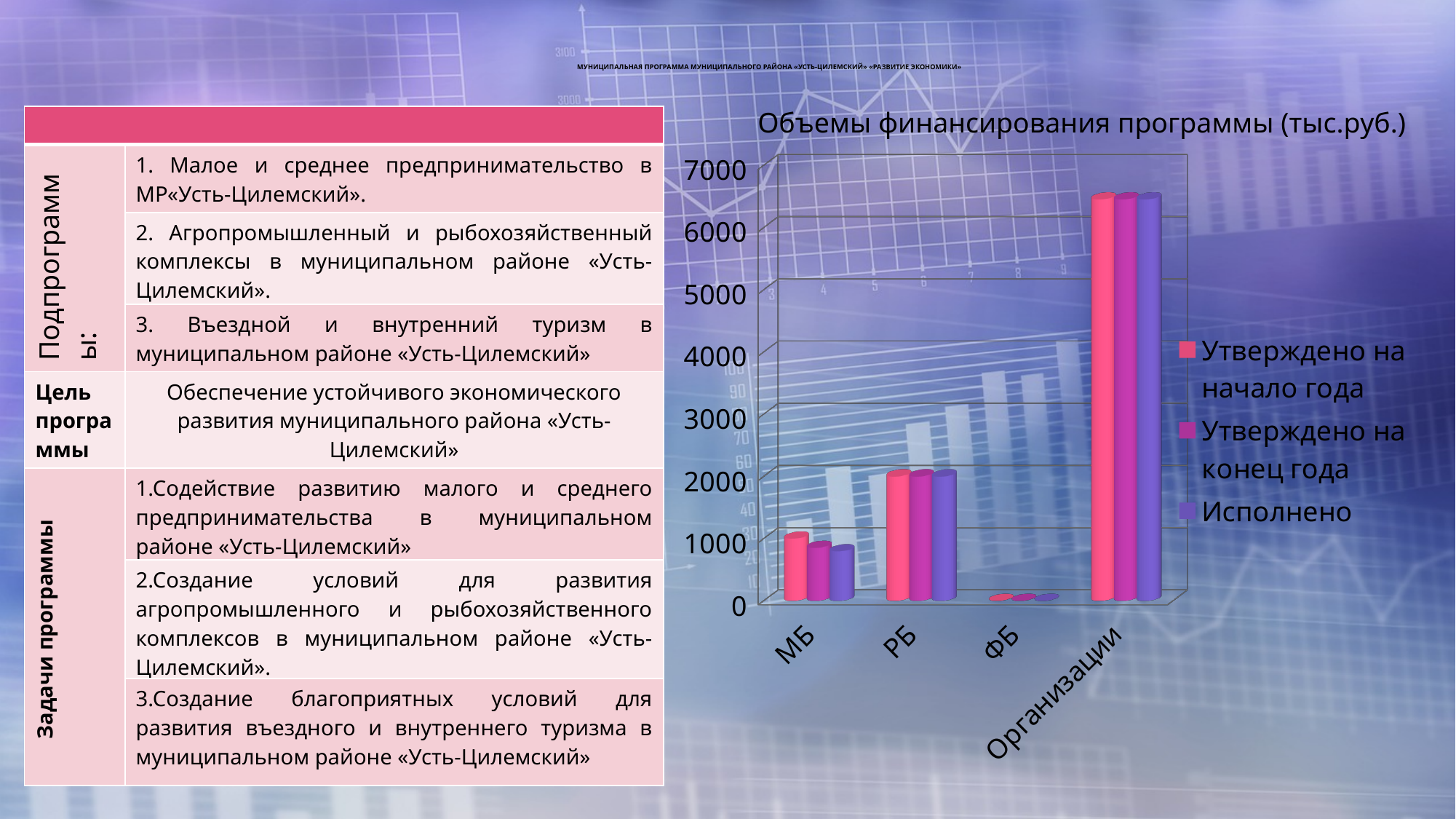
How many categories are shown on the x axis of the chart? 4 Is the value of Исполнено for ФБ greater or less than 1000? less Which category has the highest values in the chart? Организации What kind of chart is shown on the slide? bar chart Is the value of Утверждено на конец года for МБ greater or less than 2000? less How many series does the chart legend list? 3 What is the title of the chart? Объемы финансирования программы (тыс.руб.) Is the value of Утверждено на начало года for Организации greater or less than 6000? greater Which series is listed last in the chart legend? Исполнено Which category has the lowest values in the chart? ФБ Which is larger, the Исполнено value for Организации or for РБ? Организации